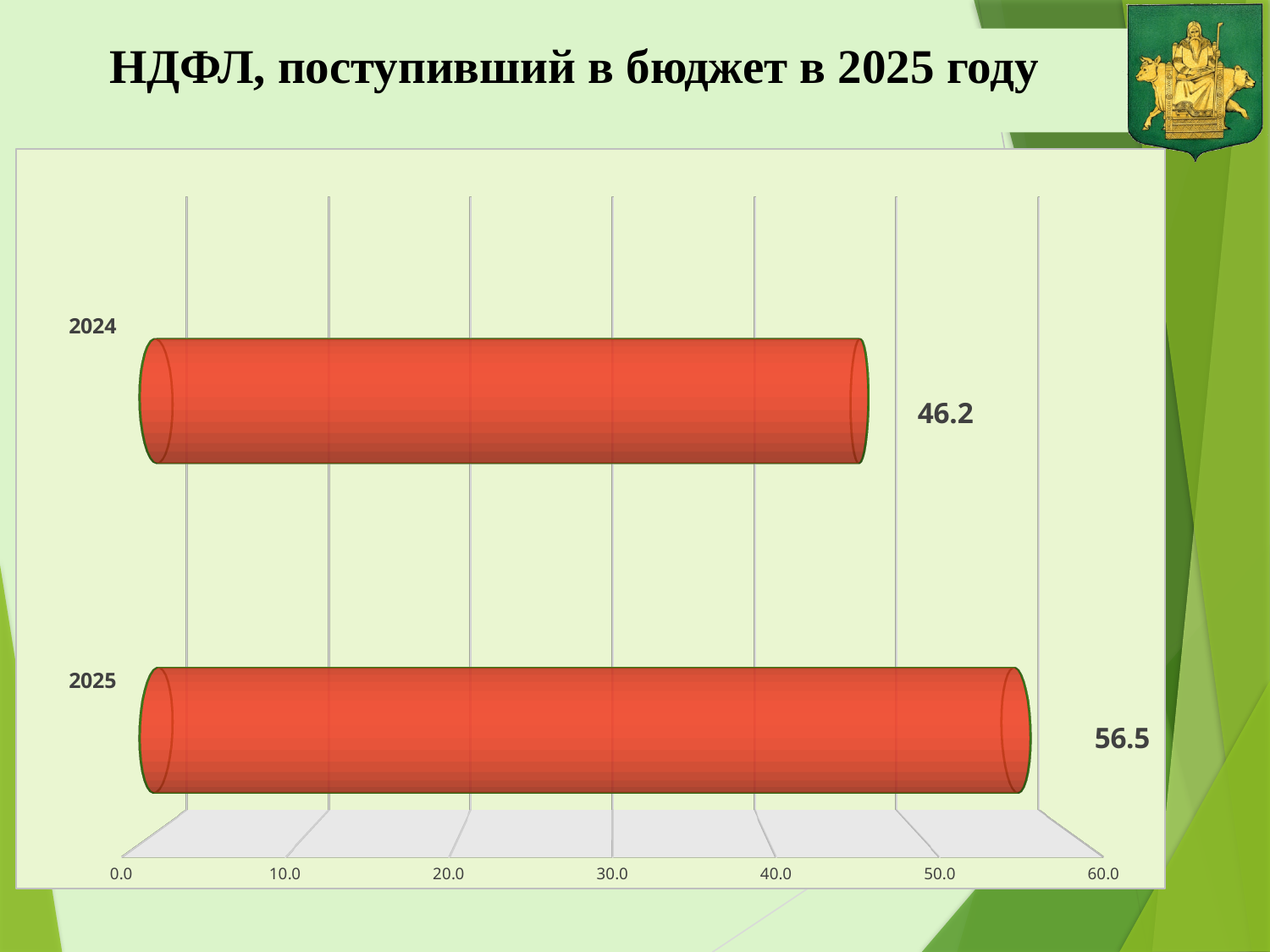
Which year has the lower value? 2024 Is the value for 2025 larger than the value for 2024? Yes What is the value for 2025? 56.5 Does the value rise or fall from 2024 to 2025? Rise Is the value for 2024 greater or less than 50.0? less How many categories (years) are shown in the chart? 2 What is the value for 2024? 46.2 Which year has the higher value? 2025 What is the difference between the values for 2025 and 2024? 10.3 What kind of chart is shown on the slide? Bar chart What is the title of the slide? НДФЛ, поступивший в бюджет в 2025 году Is the value for 2025 greater or less than 50.0? greater